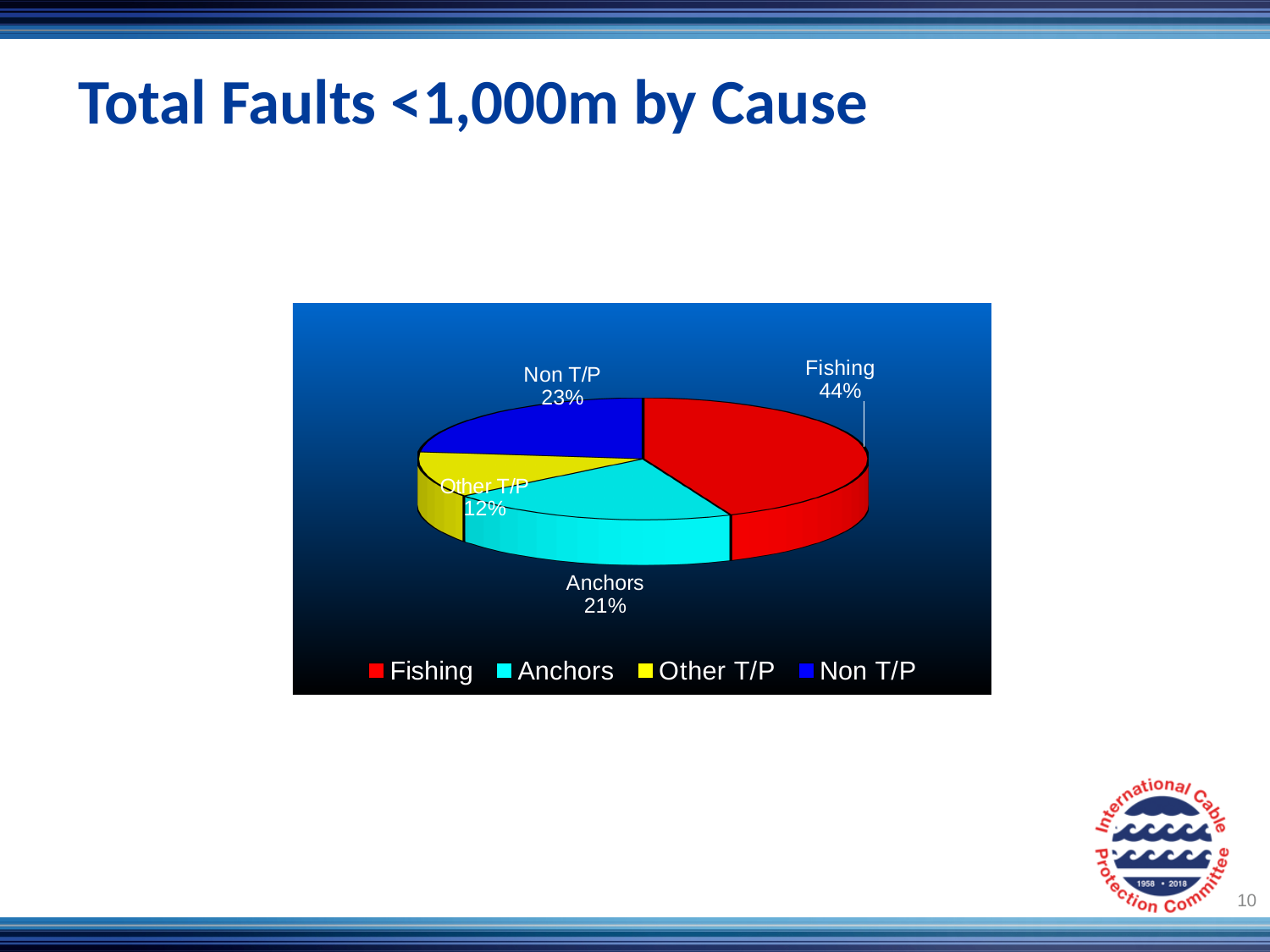
Which cause accounts for the largest share of faults? Fishing What is the title of the chart? Total Faults <1,000m by Cause What percentage of faults is attributed to Non T/P? 23% What kind of chart is shown on the slide? Pie chart What is the difference in percentage points between Fishing and Anchors? 23 What colour represents Anchors in the pie chart? Cyan Which is larger, the share for Non T/P or the share for Other T/P? Non T/P How many causes are shown in the pie chart? 4 What percentage of faults is attributed to Other T/P? 12% Which cause accounts for the smallest share of faults? Other T/P What share of total faults <1,000m is attributed to Fishing? 44% What percentage of faults is caused by Anchors? 21%